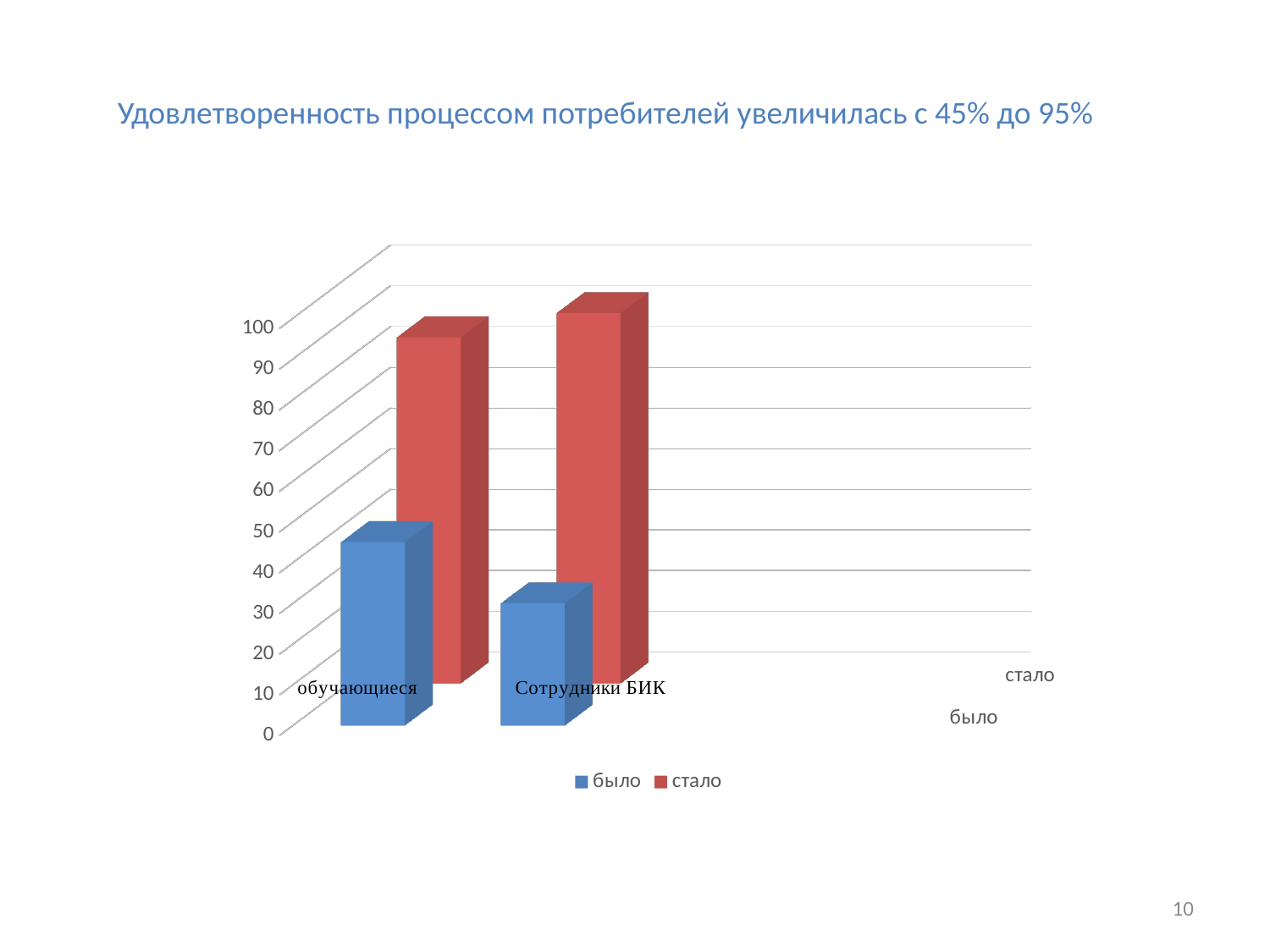
For "обучающиеся", which is larger: "было" or "стало"? стало Which category has the higher "было" value? обучающиеся Is the "стало" value for "обучающиеся" greater or less than 60? greater Which colour represents the series "стало"? red What are the two series named in the legend? было, стало Which category has the lowest "было" value? Сотрудники БИК Is the "было" value for "Сотрудники БИК" greater or less than 60? less What kind of chart is shown on the slide? bar chart How many series does the legend list? 2 For "Сотрудники БИК", which is larger: "было" or "стало"? стало Is the "стало" value for "Сотрудники БИК" greater or less than 70? greater How many categories are shown on the x axis? 2